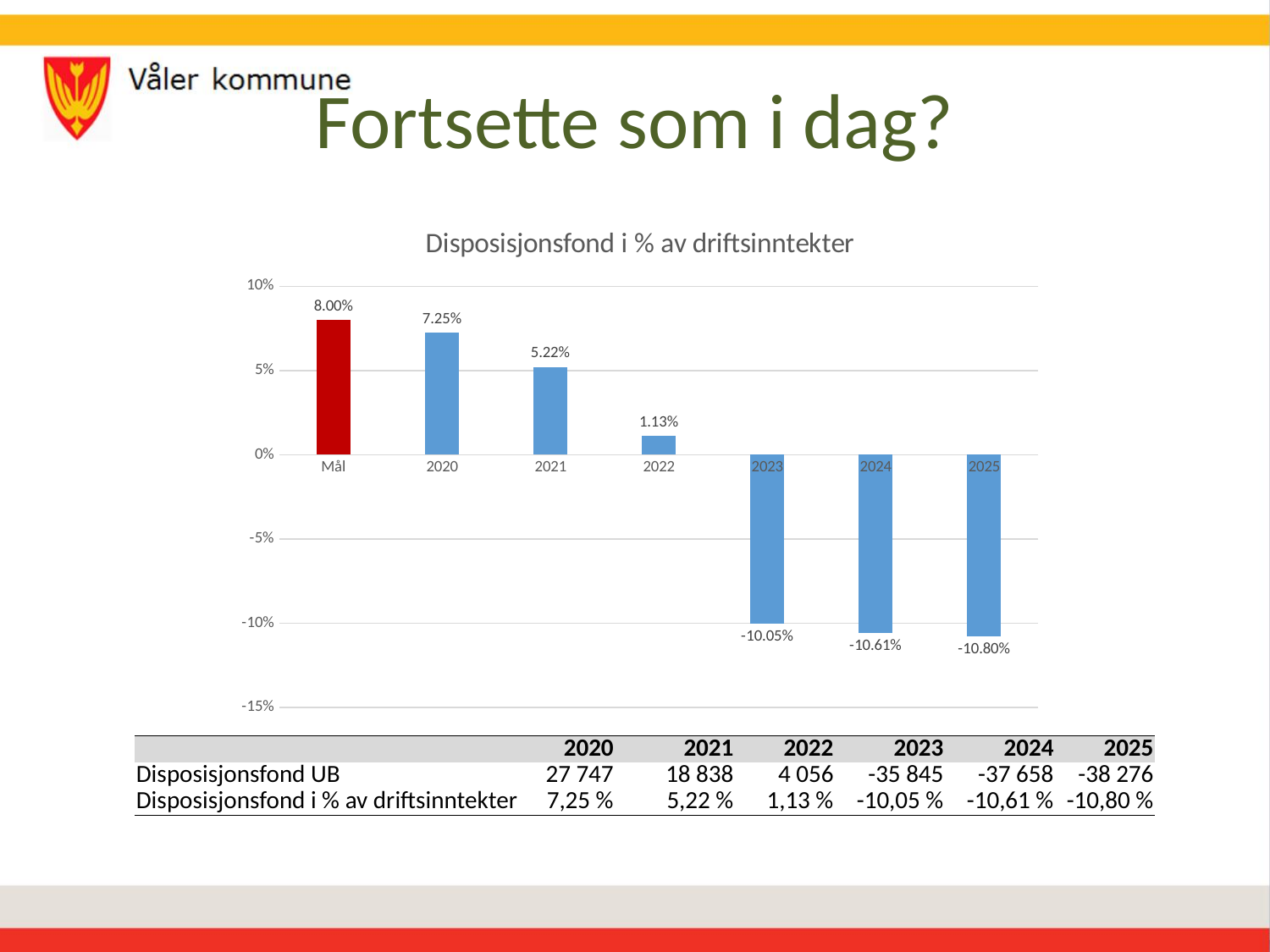
Which category has the lowest value in the chart? 2025 Which category has the highest value in the chart? Mål How many categories are shown on the x axis of the chart? 7 What is the title of the chart? Disposisjonsfond i % av driftsinntekter Is the value for 2023 greater or less than -5%? less What is the value for 2021 in the chart? 5.22% Which is larger, the value for 2022 or the value for 2021? 2021 What is the difference between the values for Mål and 2020? 0.75% What is the value for 2024 in the chart? -10.61% What kind of chart is shown on the slide? bar chart What is the value for Mål in the chart 'Disposisjonsfond i % av driftsinntekter'? 8.00% Do the values rise or fall from 2020 to 2025 in the chart? fall